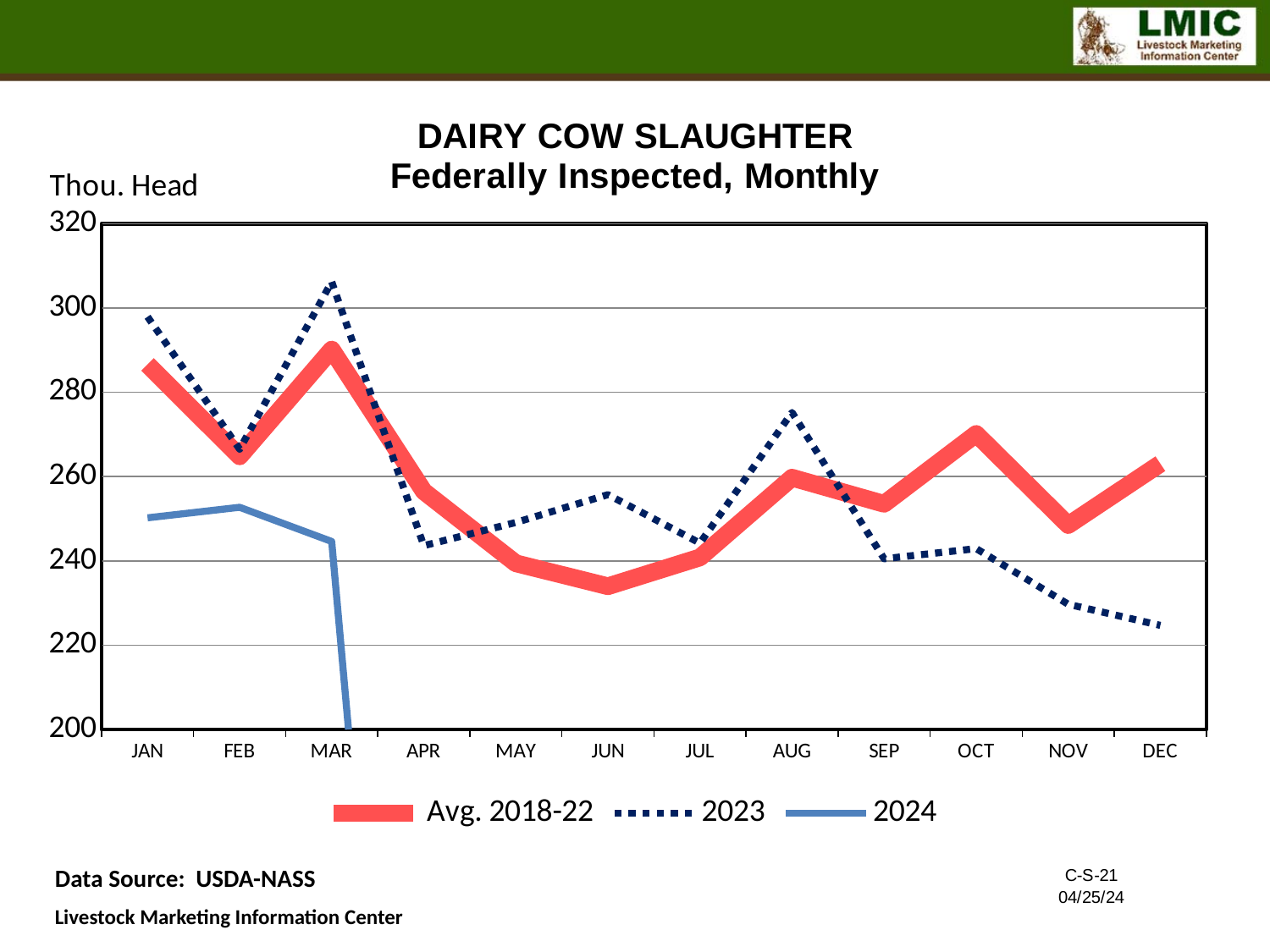
How many months are shown on the x axis? 12 What kind of chart is shown on the slide? line chart In which month is the Avg. 2018-22 series highest? MAR What unit is shown on the y axis label? Thou. Head In which month does the 2023 series reach its highest value? MAR Is the 2023 value for DEC greater or less than 240? less Is the 2023 value for MAR greater or less than 300? greater Does the 2023 series rise or fall from SEP to DEC? fall How many series does the legend list? 3 Is the 2024 value for JAN greater or less than 240? greater In which month does the 2023 series reach its lowest value? DEC In OCT, which is larger: the Avg. 2018-22 value or the 2023 value? Avg. 2018-22